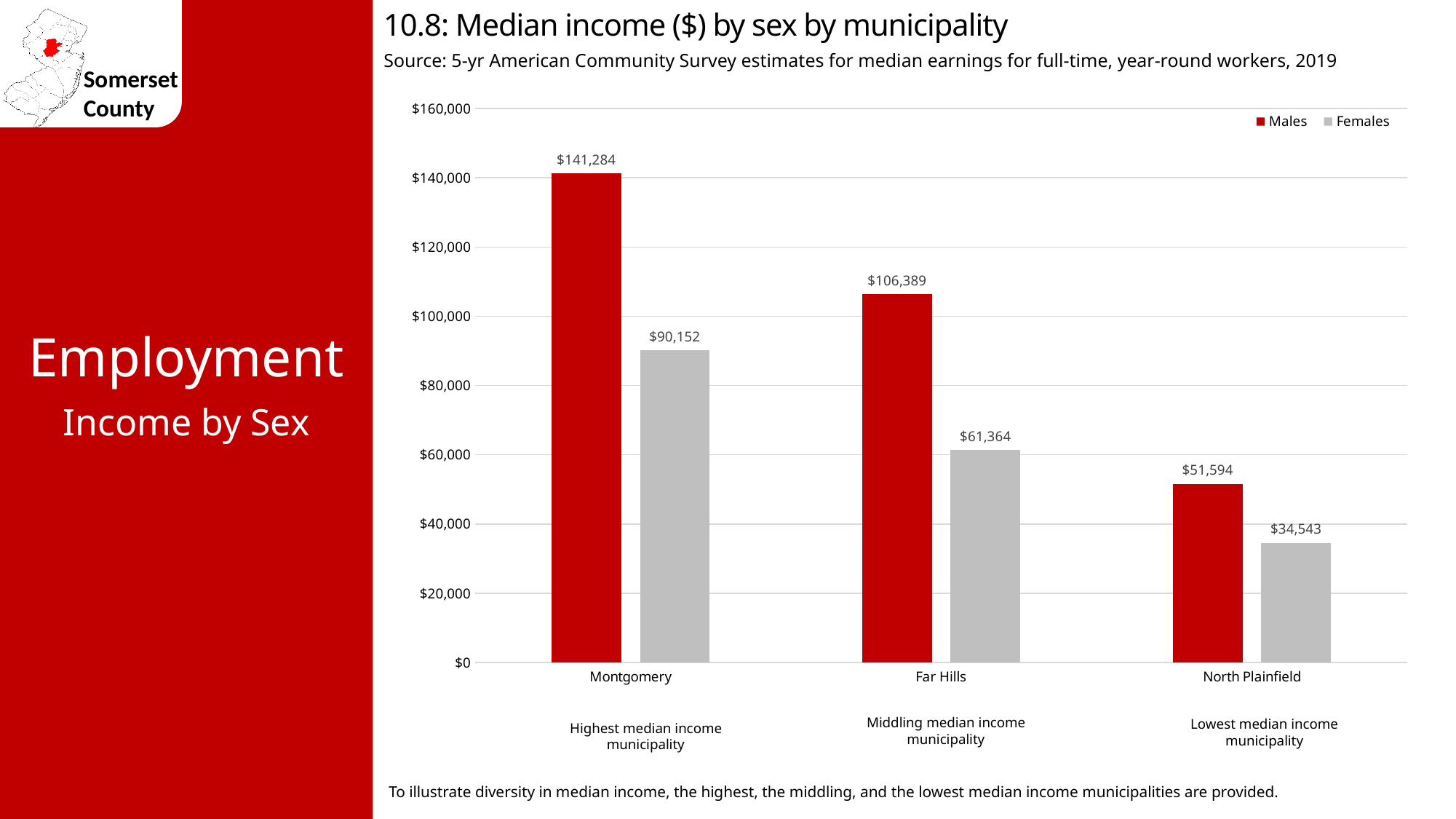
What is the median income for females in Far Hills? $61,364 Which municipality has the lowest median income for females? North Plainfield What is the difference between male and female median income in North Plainfield? $17,051 What is the median income for males in Montgomery? $141,284 Which is larger: the female median income in Montgomery or the male median income in North Plainfield? Female median income in Montgomery How many series does the legend list? 2 How many municipalities are shown on the chart? 3 Which colour represents Males in the chart? Red Which municipality has the highest median income for males? Montgomery What is the median income for females in North Plainfield? $34,543 What is the difference between male and female median income in Montgomery? $51,132 What kind of chart is shown on the slide? Bar chart